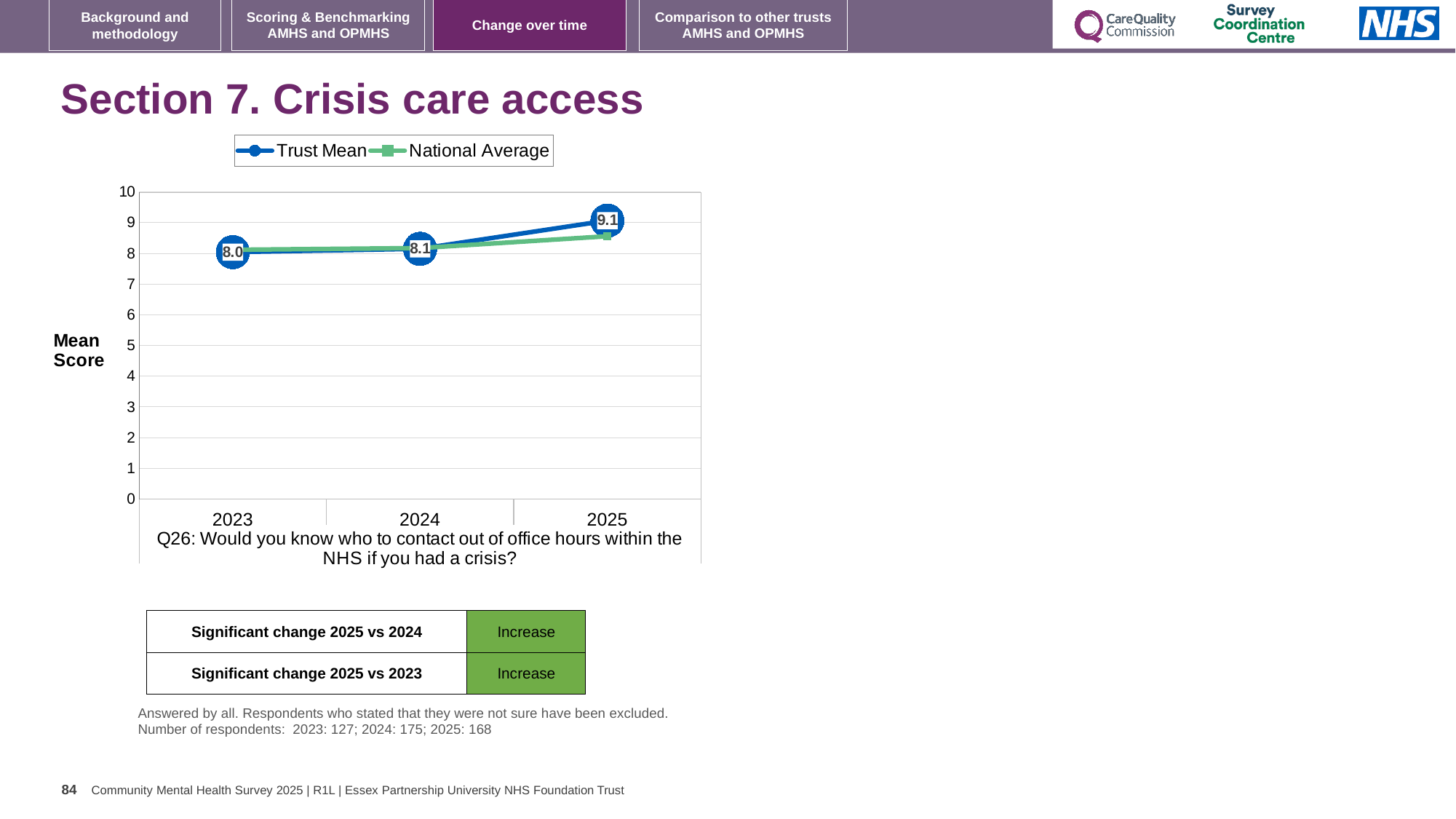
How many series does the legend list? 2 What is the difference between the Trust Mean in 2025 and in 2023? 1.1 In which year is the Trust Mean lowest? 2023 How many years are plotted on the x axis? 3 Which is larger in 2025, the Trust Mean or the National Average? Trust Mean In which year is the Trust Mean highest? 2025 What is the Trust Mean score for 2023? 8.0 What is the Trust Mean score for 2024? 8.1 What kind of chart is shown? Line chart Is the National Average for 2025 greater or less than 9? less What is the difference between the Trust Mean in 2025 and in 2024? 1.0 What is the Trust Mean score for 2025? 9.1